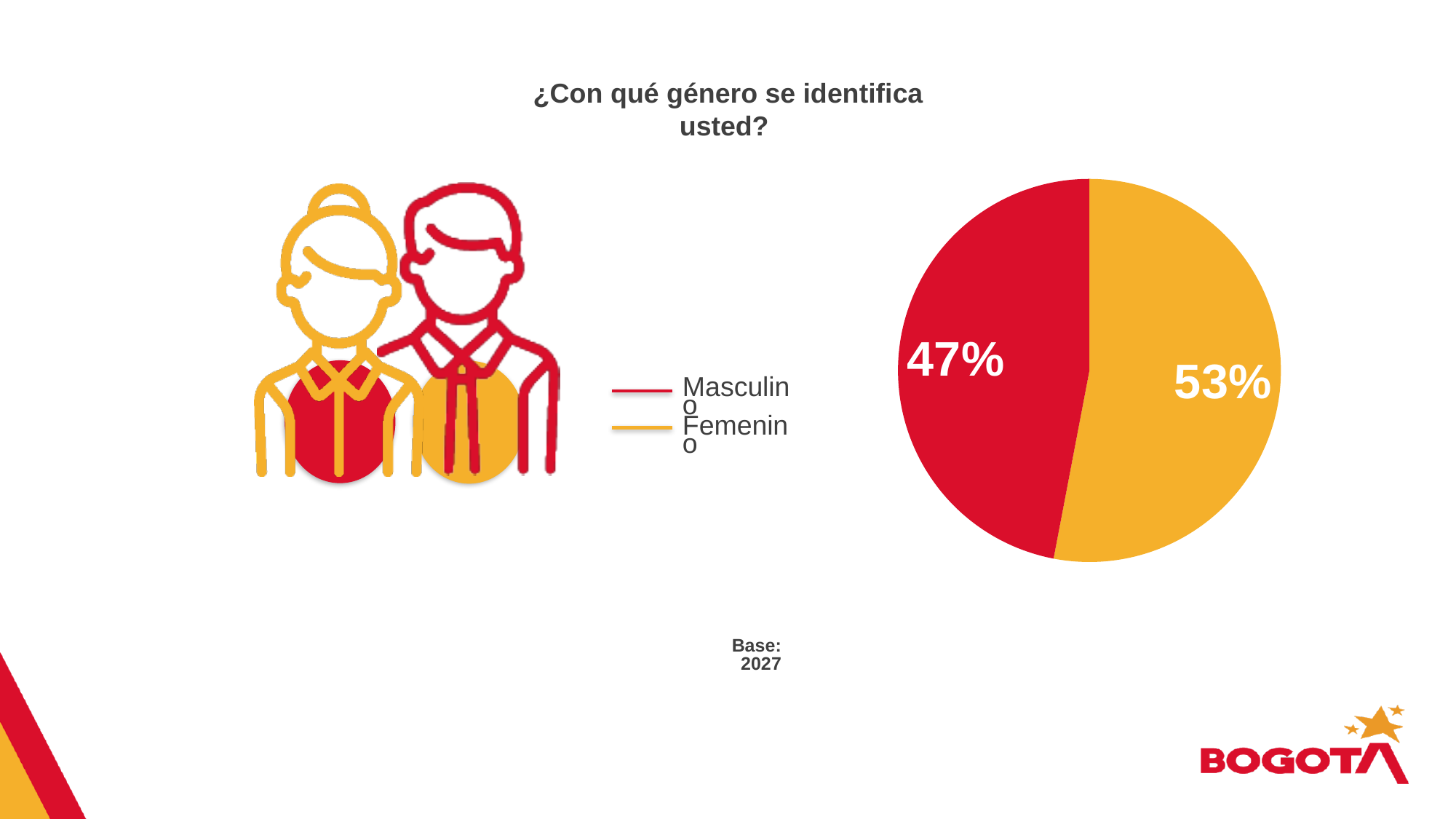
Which colour represents Masculino in the pie chart? red What percentage of respondents identify as Masculino? 47% Which gender has the smaller share in the pie chart? Masculino What is the base (number of respondents) shown below the chart? 2027 How many entries does the legend list? 2 Is the share for Femenino larger or smaller than the share for Masculino? larger What kind of chart is shown on the slide? pie chart What is the difference in percentage points between Femenino and Masculino? 6 What percentage of respondents identify as Femenino? 53% How many slices does the pie chart have? 2 Which gender has the larger share in the pie chart? Femenino What is the title of the chart? ¿Con qué género se identifica usted?